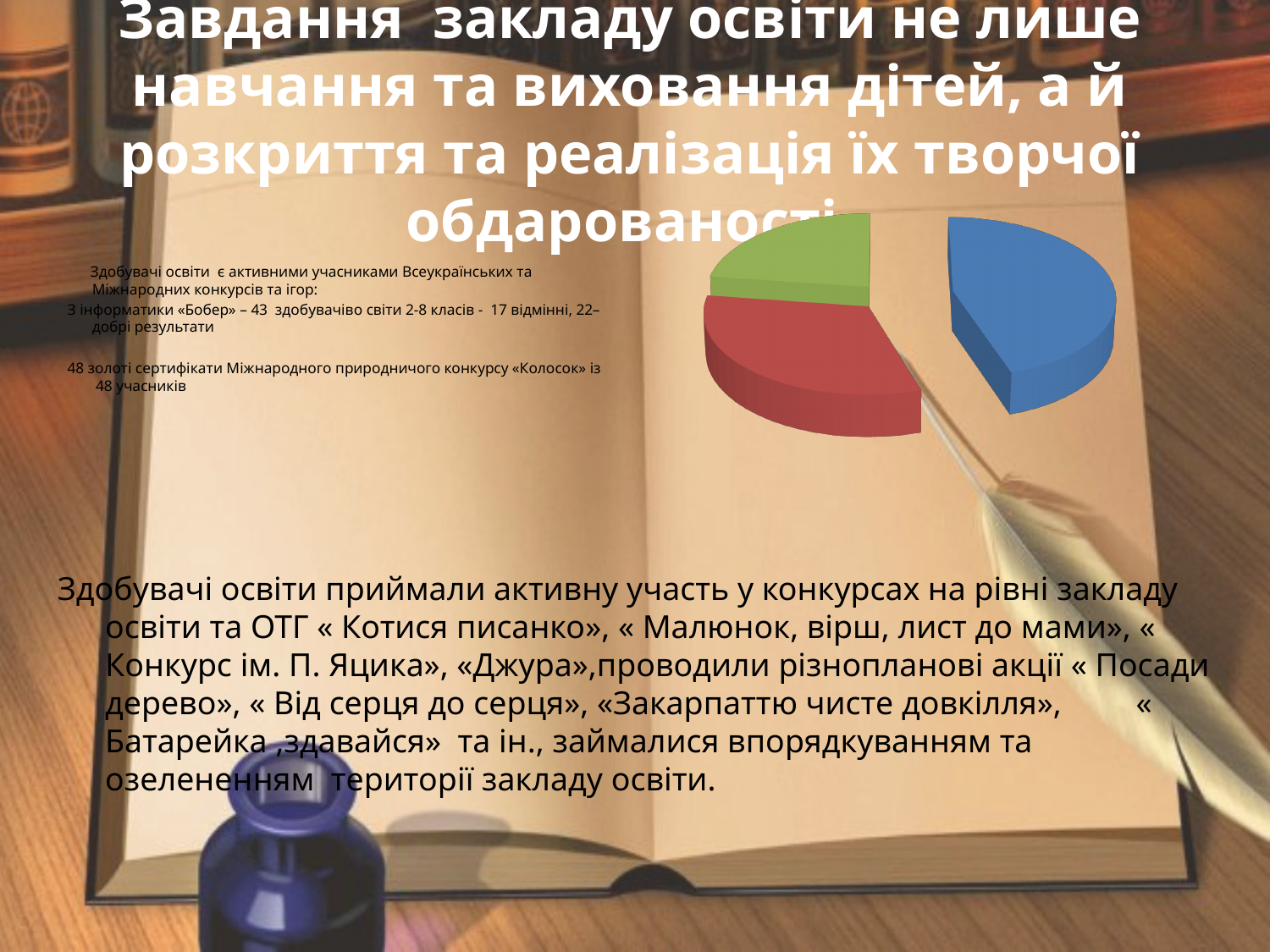
Which colour slice of the pie chart is the smallest? green Which colour slice is pulled out (exploded) from the rest of the pie chart? blue Does the pie chart display a legend? no How many slices does the pie chart have? 3 Which slice of the pie chart is larger, the green one or the red one? red Which slice of the pie chart is larger, the green one or the blue one? blue What kind of chart is shown on the slide? pie chart